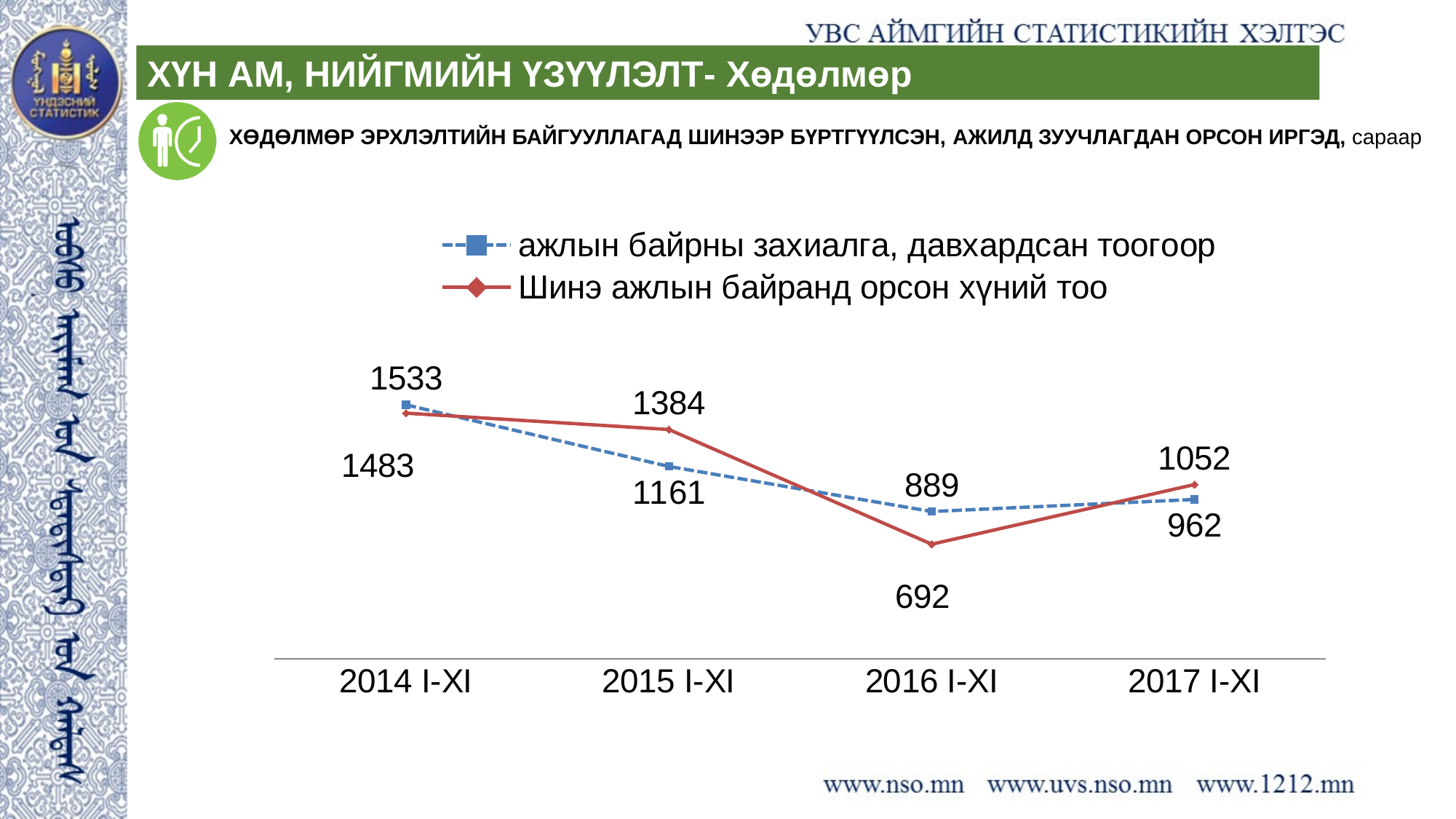
Does 'ажлын байрны захиалга, давхардсан тоогоор' rise or fall from 2014 I-XI to 2016 I-XI? fall What is the value of 'Шинэ ажлын байранд орсон хүний тоо' for 2017 I-XI? 1052 In 2017 I-XI, which series has the larger value: 'ажлын байрны захиалга, давхардсан тоогоор' or 'Шинэ ажлын байранд орсон хүний тоо'? Шинэ ажлын байранд орсон хүний тоо What type of chart is shown on the slide? line chart What is the value of 'ажлын байрны захиалга, давхардсан тоогоор' for 2014 I-XI? 1533 In which period is 'Шинэ ажлын байранд орсон хүний тоо' lowest? 2016 I-XI What is the value of 'ажлын байрны захиалга, давхардсан тоогоор' for 2015 I-XI? 1161 What is the difference between 'ажлын байрны захиалга, давхардсан тоогоор' and 'Шинэ ажлын байранд орсон хүний тоо' in 2016 I-XI? 197 What is the value of 'Шинэ ажлын байранд орсон хүний тоо' for 2016 I-XI? 692 How many series does the legend list? 2 In which period is 'ажлын байрны захиалга, давхардсан тоогоор' highest? 2014 I-XI How many periods are shown on the x axis? 4